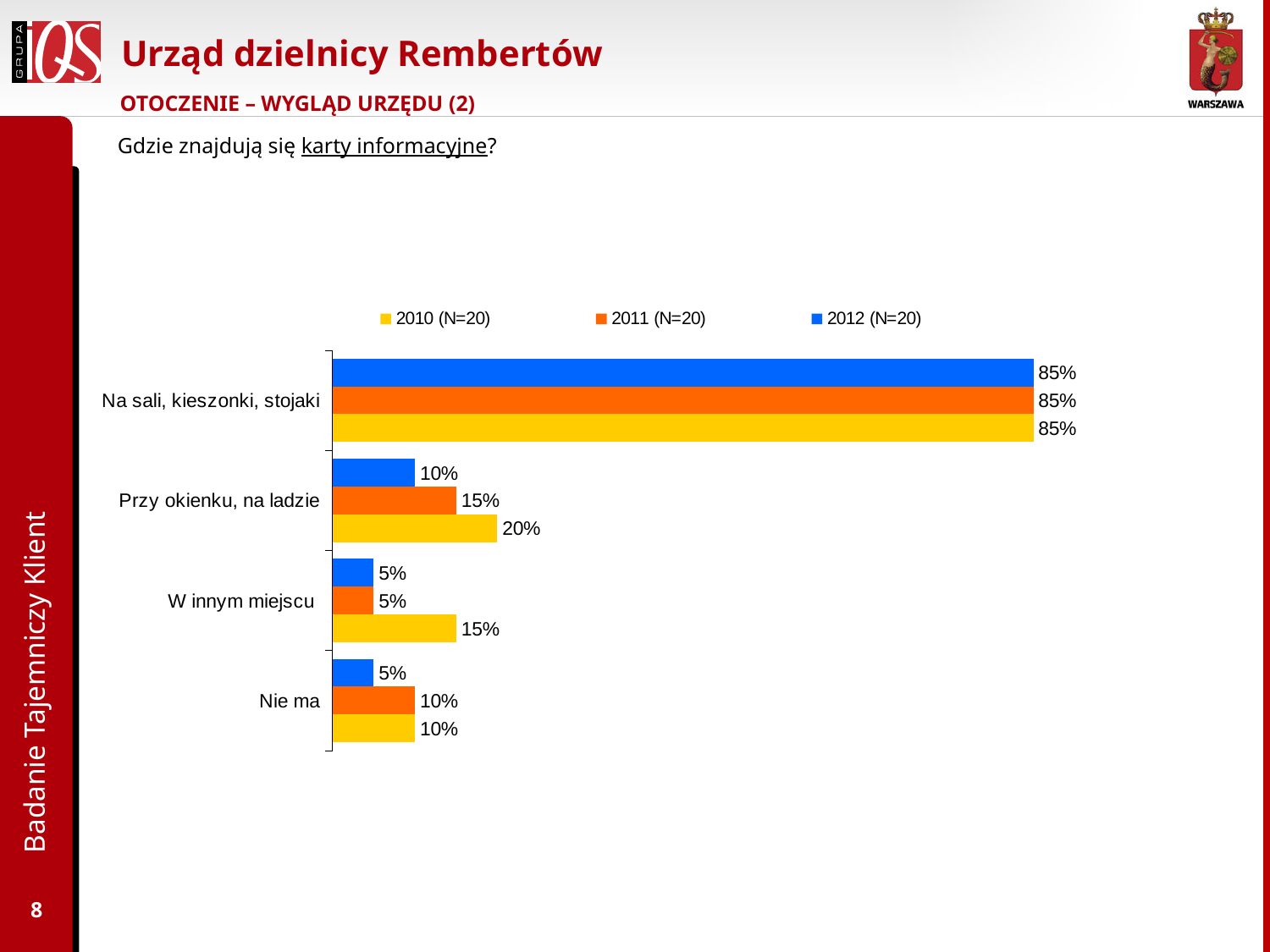
What is the value for "Na sali, kieszonki, stojaki" in the 2012 (N=20) series? 85% What is the value for "Nie ma" in the 2011 (N=20) series? 10% Which category has the highest value in the 2011 (N=20) series? Na sali, kieszonki, stojaki How many series does the legend list? 3 How many categories are shown on the chart? 4 What is the difference between the 2010 (N=20) and 2012 (N=20) values for "Przy okienku, na ladzie"? 10% Which category has the lowest value in the 2010 (N=20) series? Nie ma What kind of chart is shown on the slide? bar chart Which colour represents the 2012 (N=20) series? blue Which is larger for "W innym miejscu": the 2010 (N=20) value or the 2011 (N=20) value? 2010 (N=20) What is the value for "W innym miejscu" in the 2012 (N=20) series? 5% What is the value for "Przy okienku, na ladzie" in the 2010 (N=20) series? 20%